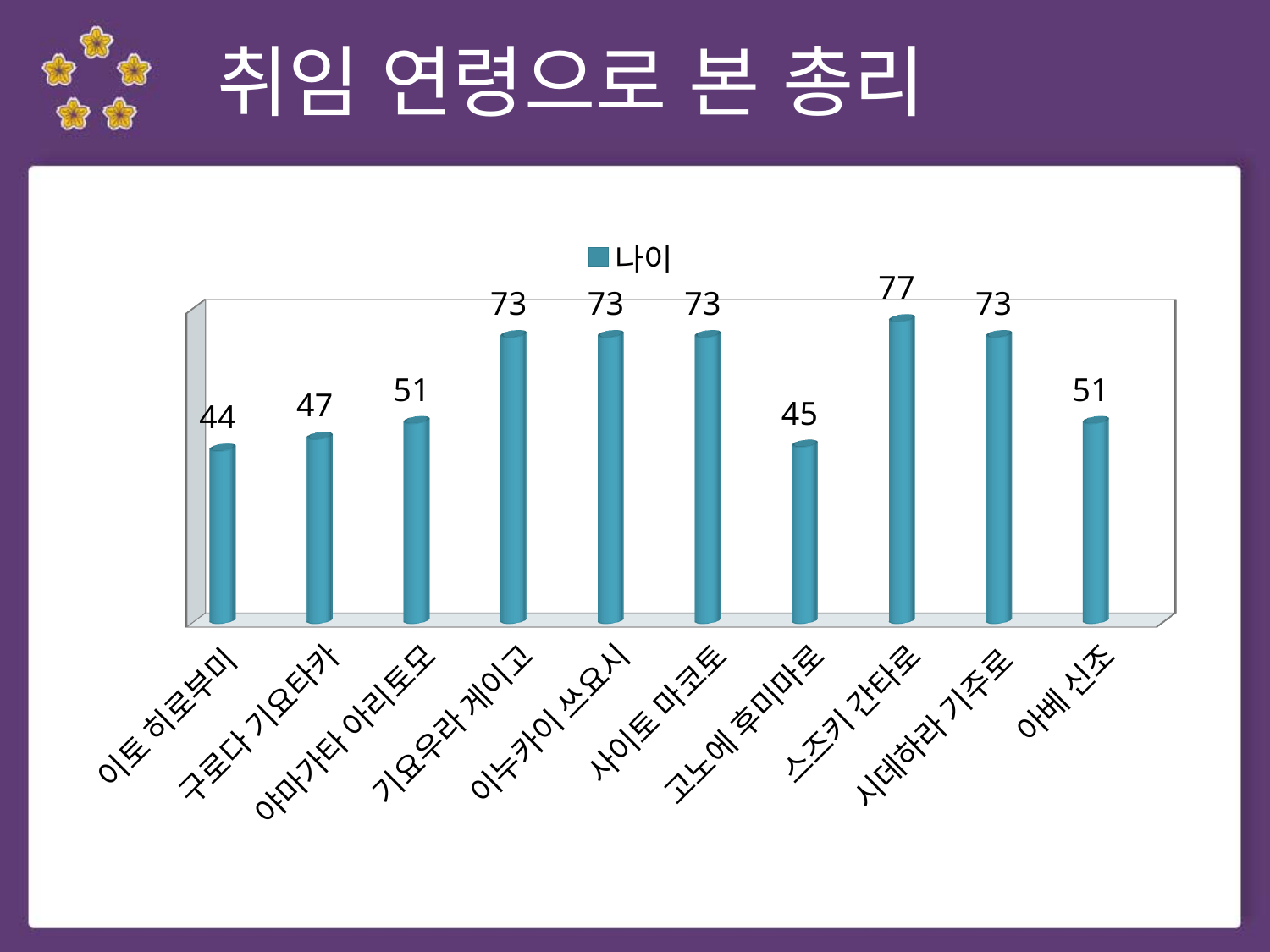
What is the value for 아베 신조? 51 How many categories are shown on the x axis? 10 How many series does the legend list? 1 Which is larger, the value for 구로다 기요타카 or the value for 야마가타 아리토모? 야마가타 아리토모 What is the value for 이토 히로부미? 44 What is the legend entry for the series? 나이 Which category has the lowest value? 이토 히로부미 What kind of chart is shown on the slide? bar chart What is the difference between the values for 스즈키 간타로 and 이토 히로부미? 33 Which category has the highest value? 스즈키 간타로 What is the value for 고노에 후미마로? 45 What is the value for 스즈키 간타로? 77